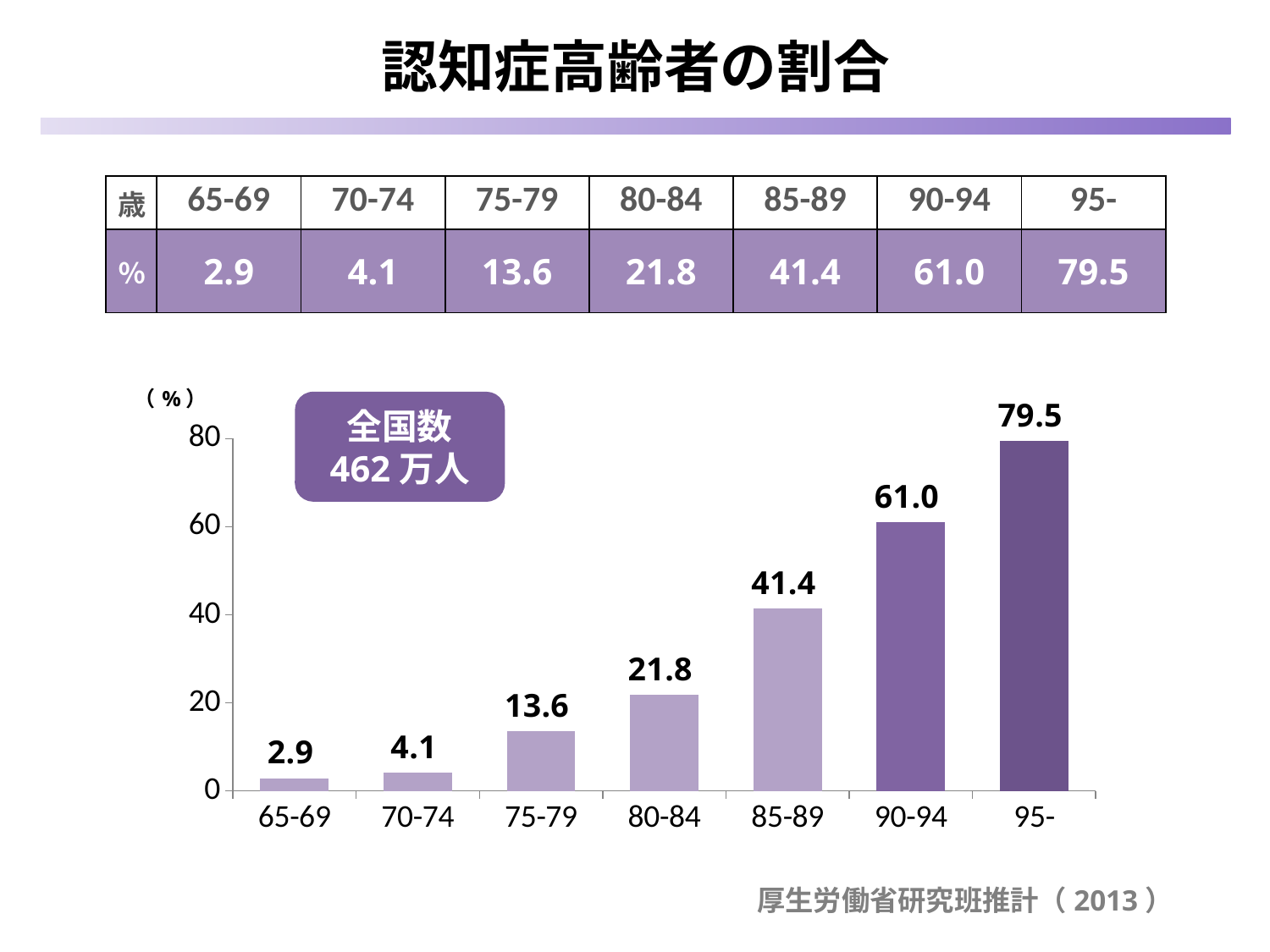
What is the value for the 95- age group? 79.5 Do the values rise or fall as age increases along the x axis? rise What kind of chart is shown on the slide? bar chart How many age groups are shown on the chart? 7 What is the value for the 85-89 age group? 41.4 Which age group has the highest value? 95- What is the value for the 70-74 age group? 4.1 What is the difference between the values for 80-84 and 75-79? 8.2 What is the difference between the values for 90-94 and 85-89? 19.6 Which age group has the lowest value? 65-69 Is the value for 90-94 greater or less than 60? greater Which is larger, the value for 80-84 or the value for 75-79? 80-84